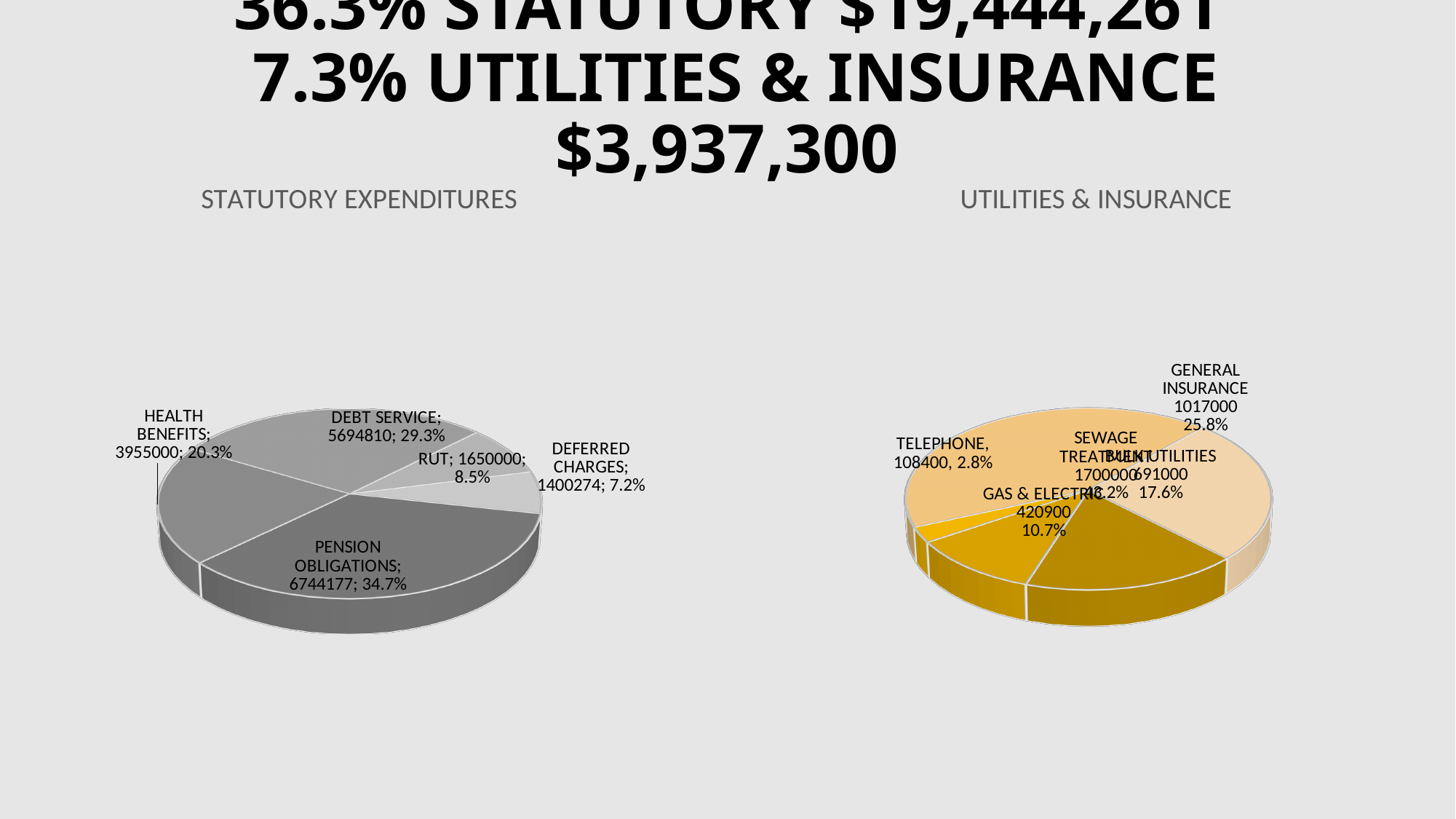
On the Statutory Expenditures chart, what percentage share does Debt Service have? 29.3% On the Utilities & Insurance chart, what is the value for General Insurance? 1017000 On the Statutory Expenditures chart, what is the difference between the Debt Service value and the Health Benefits value? 1739810 On the Utilities & Insurance chart, which category has the smallest slice? Telephone On the Statutory Expenditures chart, which category has the largest slice? Pension Obligations What kind of chart is the Utilities & Insurance chart? Pie chart On the Statutory Expenditures chart, how many categories are shown? 5 On the Statutory Expenditures chart, which category has the smallest slice? Deferred Charges What is the title of the chart on the left side of the slide? Statutory Expenditures On the Utilities & Insurance chart, which is larger, Bulk Utilities or General Insurance? General Insurance On the Statutory Expenditures chart, what is the value for Pension Obligations? 6744177 On the Utilities & Insurance chart, what percentage share does Gas & Electric have? 10.7%